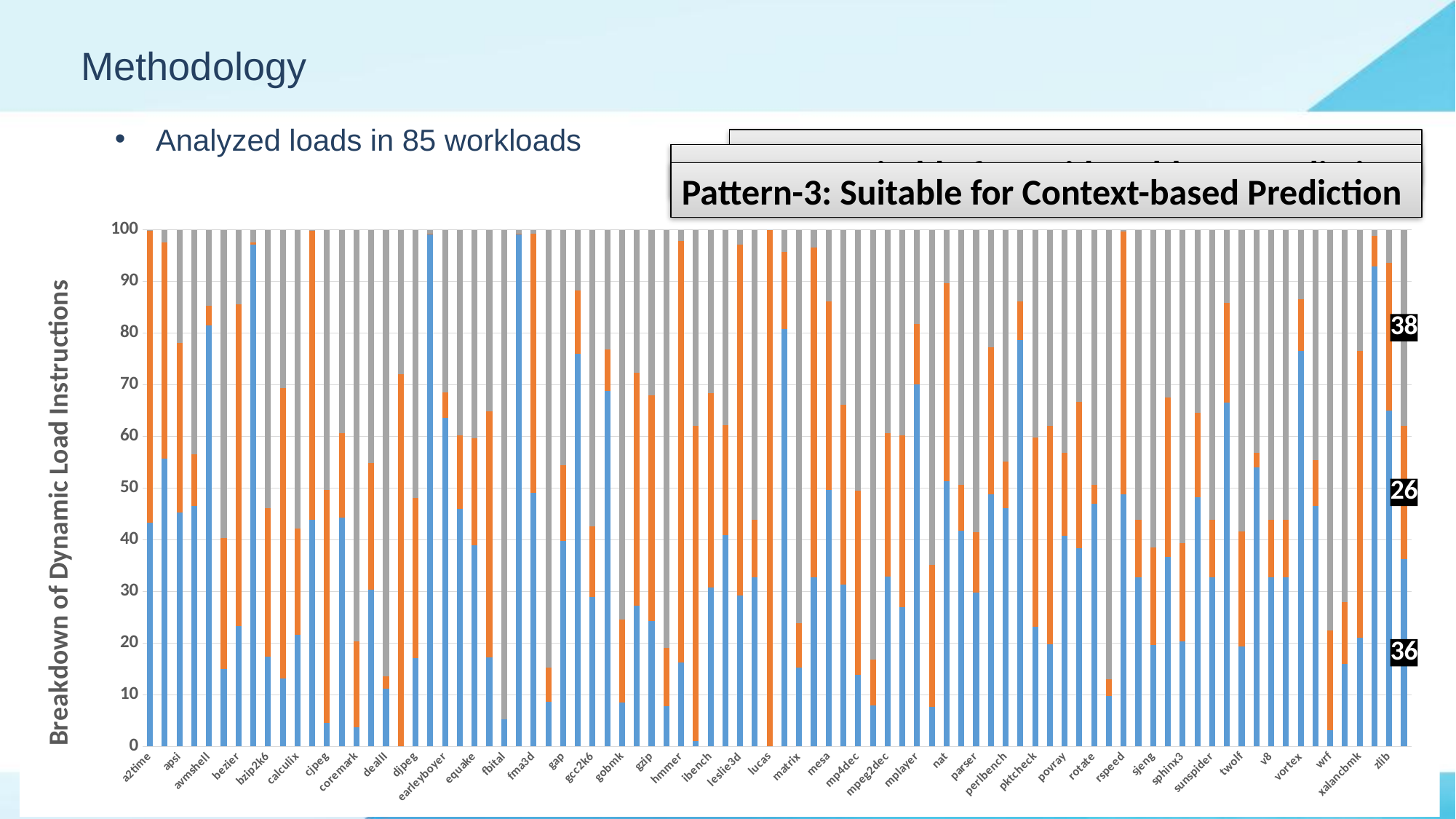
In the rightmost bar, which is larger: the top (gray) segment or the middle (orange) segment? The top (gray) segment, 38 What is the value of the middle (orange) segment of the rightmost bar in the chart? 26 What is the total of the three labeled segments of the rightmost bar? 100 In the rightmost bar, which labeled segment is the smallest? The middle (orange) segment, 26 What is the first category label on the x-axis of the chart? a2time What is the value of the top (gray) segment of the rightmost bar in the chart? 38 What is the value of the bottom (blue) segment of the rightmost bar in the chart? 36 What is the label on the y-axis of the chart? Breakdown of Dynamic Load Instructions What is the maximum value shown on the y-axis of the chart? 100 Is the blue segment for a2time greater or less than 50? less In the rightmost bar, what is the difference between the top (gray) segment and the middle (orange) segment? 12 What kind of chart is shown on the slide? Stacked bar chart